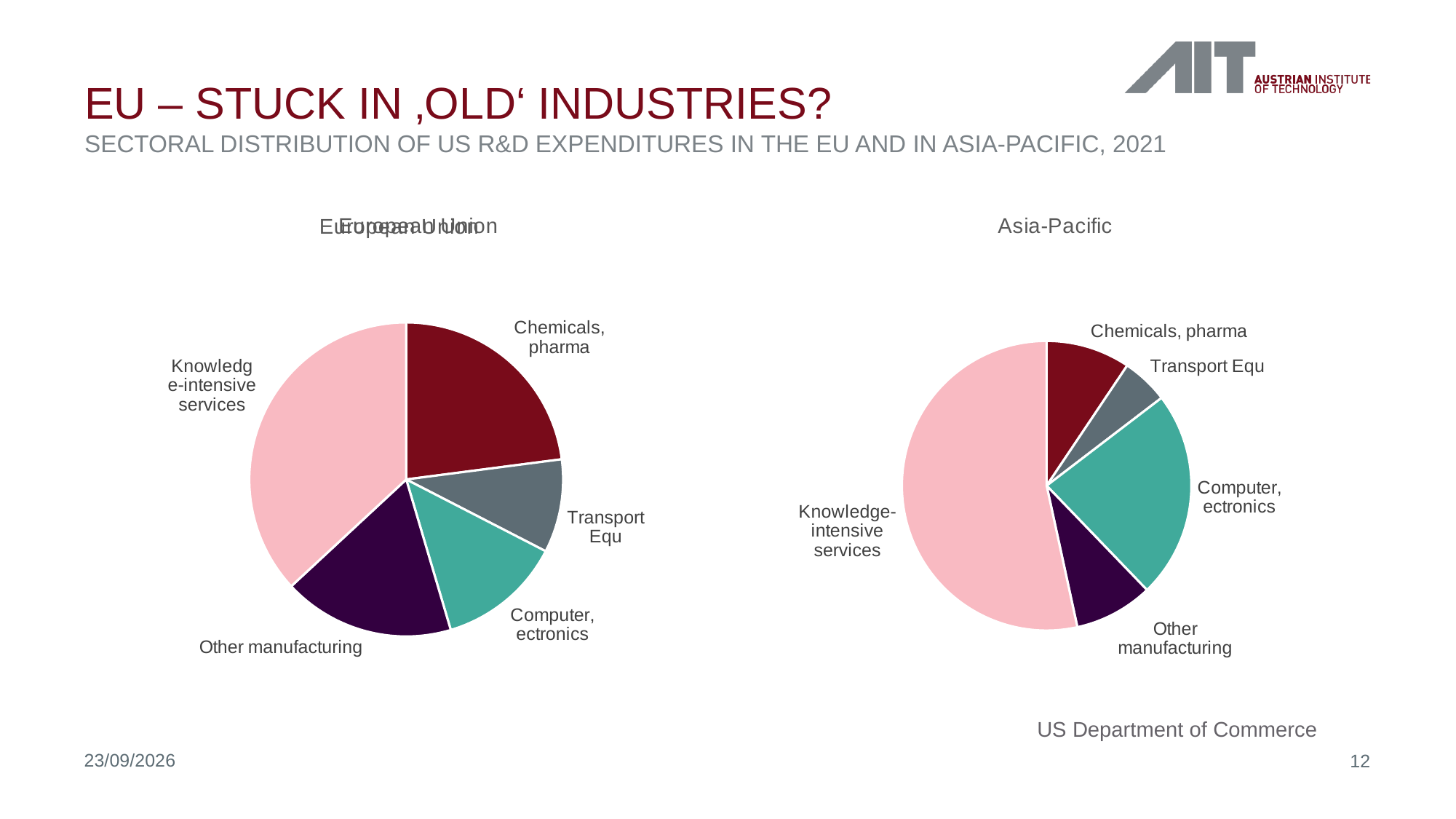
In the European Union pie chart, which slice is larger: Chemicals, pharma or Computer, electronics? Chemicals, pharma What kind of chart is the Asia-Pacific chart on the right? Pie chart How many slices does the Asia-Pacific pie chart have? 5 How many slices does the European Union pie chart have? 5 In the Asia-Pacific pie chart, which sector has the largest slice? Knowledge-intensive services In the Asia-Pacific pie chart, which sector has the smallest slice? Transport Equ In the European Union pie chart, which slice is larger: Other manufacturing or Transport Equ? Other manufacturing In the Asia-Pacific pie chart, which slice is larger: Computer, electronics or Chemicals, pharma? Computer, electronics What is the title of the pie chart on the right? Asia-Pacific In the European Union pie chart, which sector has the smallest slice? Transport Equ In the European Union pie chart, which sector has the largest slice? Knowledge-intensive services What kind of chart is the European Union chart on the left? Pie chart